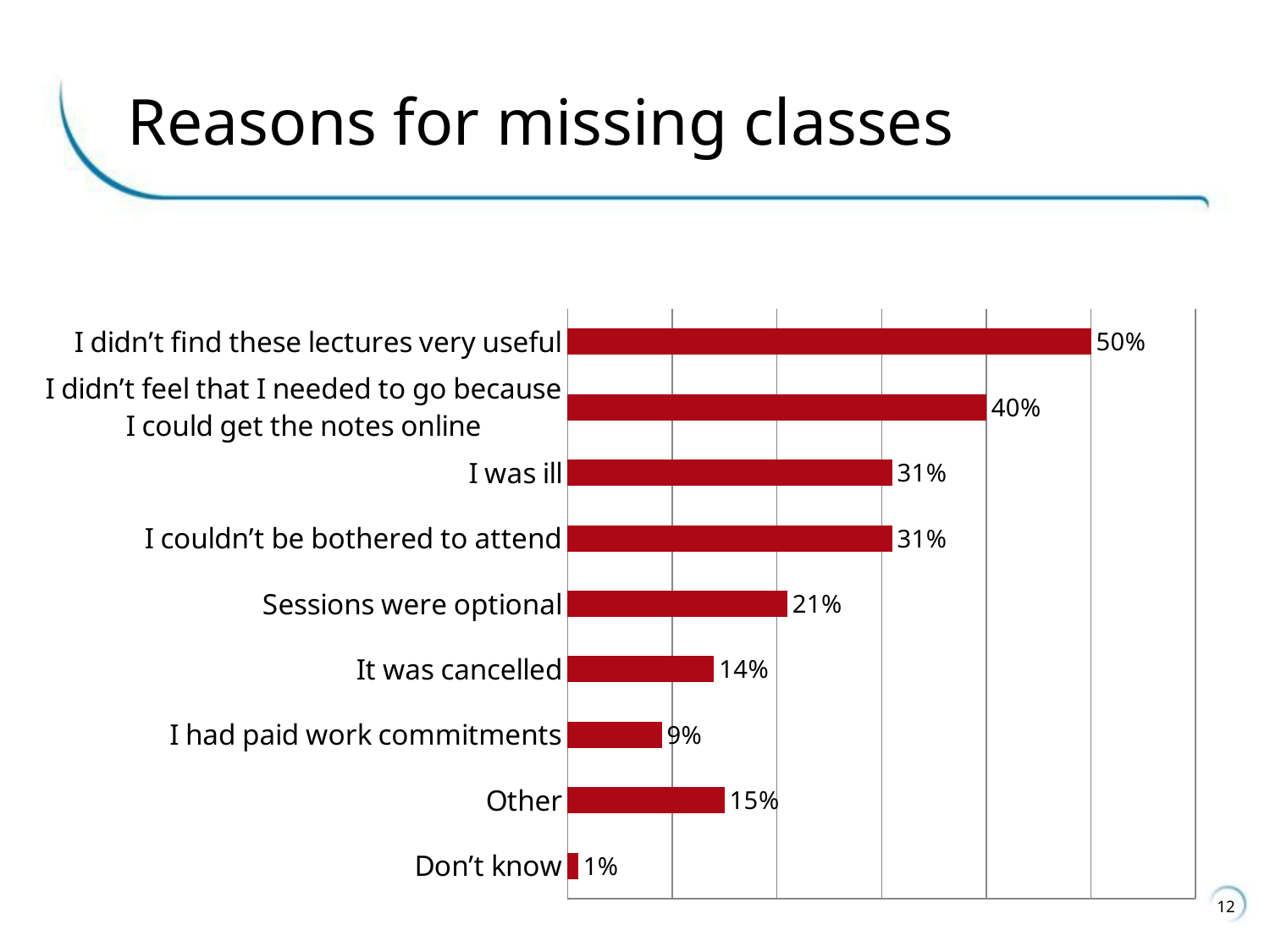
What is the difference between 'Other' and 'It was cancelled'? 1% What kind of chart is shown on the slide? Bar chart Which is larger, 'Sessions were optional' or 'It was cancelled'? Sessions were optional What is the value for 'I had paid work commitments'? 9% Which reason for missing classes has the lowest value? Don't know How many reasons (categories) are shown in the chart? 9 What is the value for 'Sessions were optional'? 21% What percentage of respondents said they didn't find these lectures very useful? 50% What is the title of the slide? Reasons for missing classes What is the value for 'I was ill'? 31% Which reason for missing classes has the highest value? I didn't find these lectures very useful What is the difference between 'I didn't find these lectures very useful' and 'I didn't feel that I needed to go because I could get the notes online'? 10%